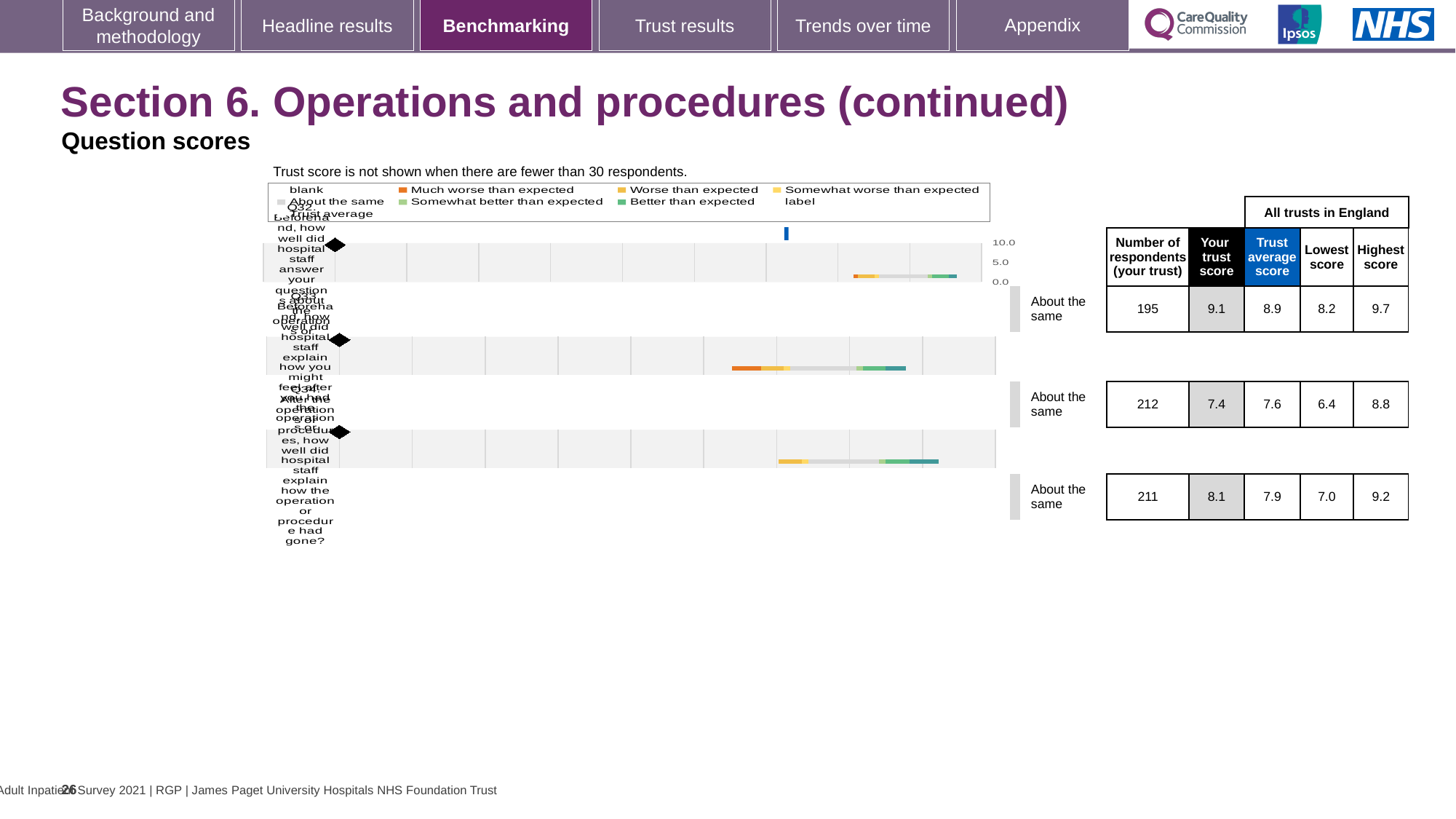
Is your trust score for the second question row larger or smaller than the trust average score for that row? smaller Which question row has the lowest 'Your trust score'? the second row (7.4) What is the number of respondents (your trust) for the first question row? 195 What is the difference between the highest score and the lowest score for the third question row? 2.2 Which question row has the highest 'Your trust score'? the first row (9.1) What is the trust average score for the third question row? 7.9 What benchmark category is shown for all three question rows? About the same What is the highest score across all trusts in England for the first question row? 9.7 How many questions (rows) are plotted in the benchmarking chart? 3 What is your trust score for the second question row? 7.4 What is the lowest score across all trusts in England for the second question row? 6.4 What type of chart is used to show the question scores? bar chart